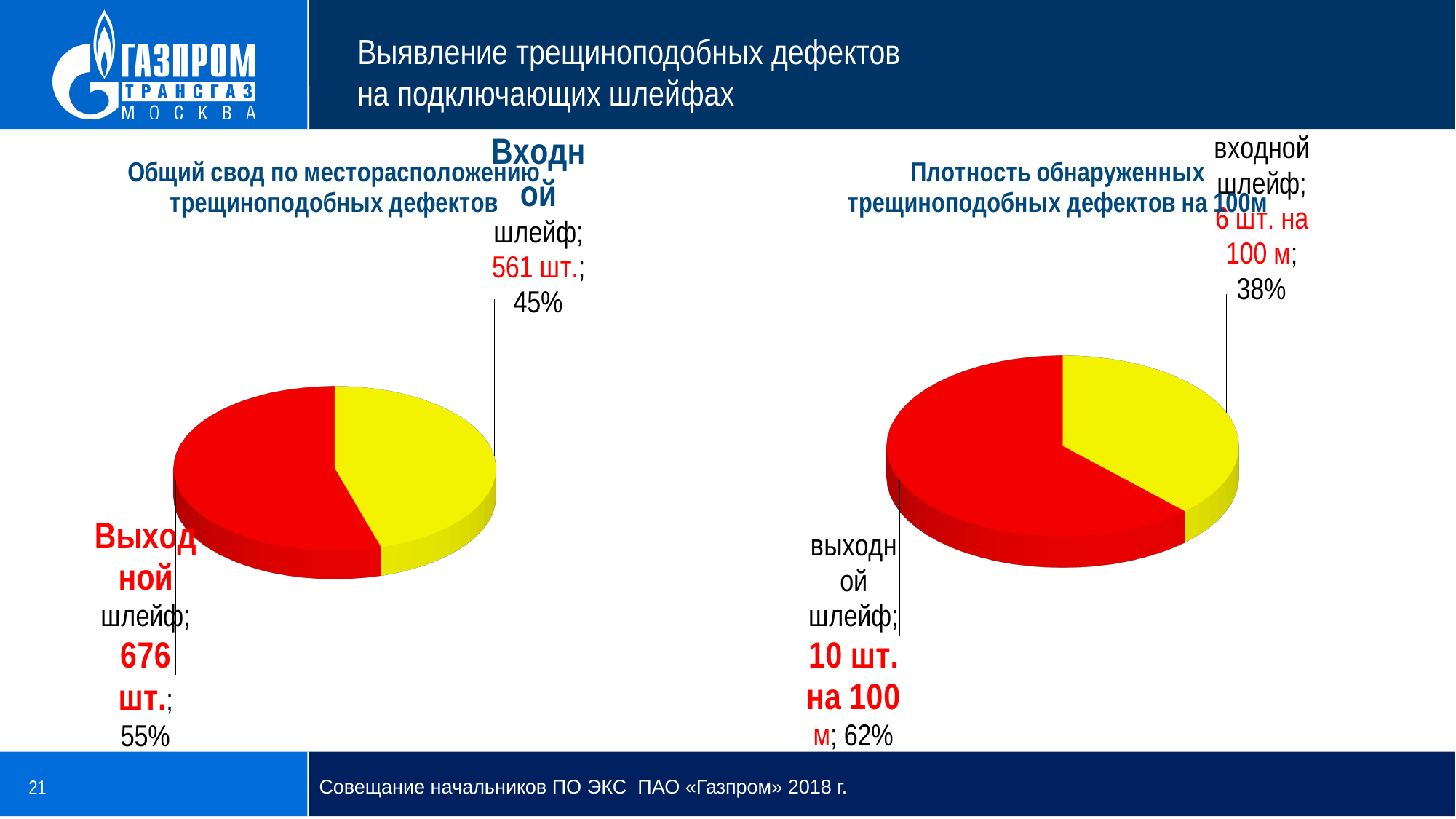
In the left chart «Общий свод по месторасположению трещиноподобных дефектов», how many slices does the pie have? 2 In the left chart «Общий свод по месторасположению трещиноподобных дефектов», which slice is larger: «Входной шлейф» or «Выходной шлейф»? Выходной шлейф In the left chart «Общий свод по месторасположению трещиноподобных дефектов», how many defects are shown for «Выходной шлейф»? 676 шт. In the right chart «Плотность обнаруженных трещиноподобных дефектов на 100м», what colour is the slice for «выходной шлейф»? red In the right chart «Плотность обнаруженных трещиноподобных дефектов на 100м», what is the defect density for «входной шлейф»? 6 шт. на 100 м In the right chart «Плотность обнаруженных трещиноподобных дефектов на 100м», which category has the highest defect density? выходной шлейф In the right chart «Плотность обнаруженных трещиноподобных дефектов на 100м», what is the defect density for «выходной шлейф»? 10 шт. на 100 м In the left chart «Общий свод по месторасположению трещиноподобных дефектов», how many defects are shown for «Входной шлейф»? 561 шт. In the left chart «Общий свод по месторасположению трещиноподобных дефектов», what is the difference in defect count between «Выходной шлейф» and «Входной шлейф»? 115 шт. In the left chart «Общий свод по месторасположению трещиноподобных дефектов», what share of the pie does «Выходной шлейф» take? 55% What type of chart is used on the left chart titled «Общий свод по месторасположению трещиноподобных дефектов»? pie chart In the right chart «Плотность обнаруженных трещиноподобных дефектов на 100м», what share of the pie does «входной шлейф» take? 38%